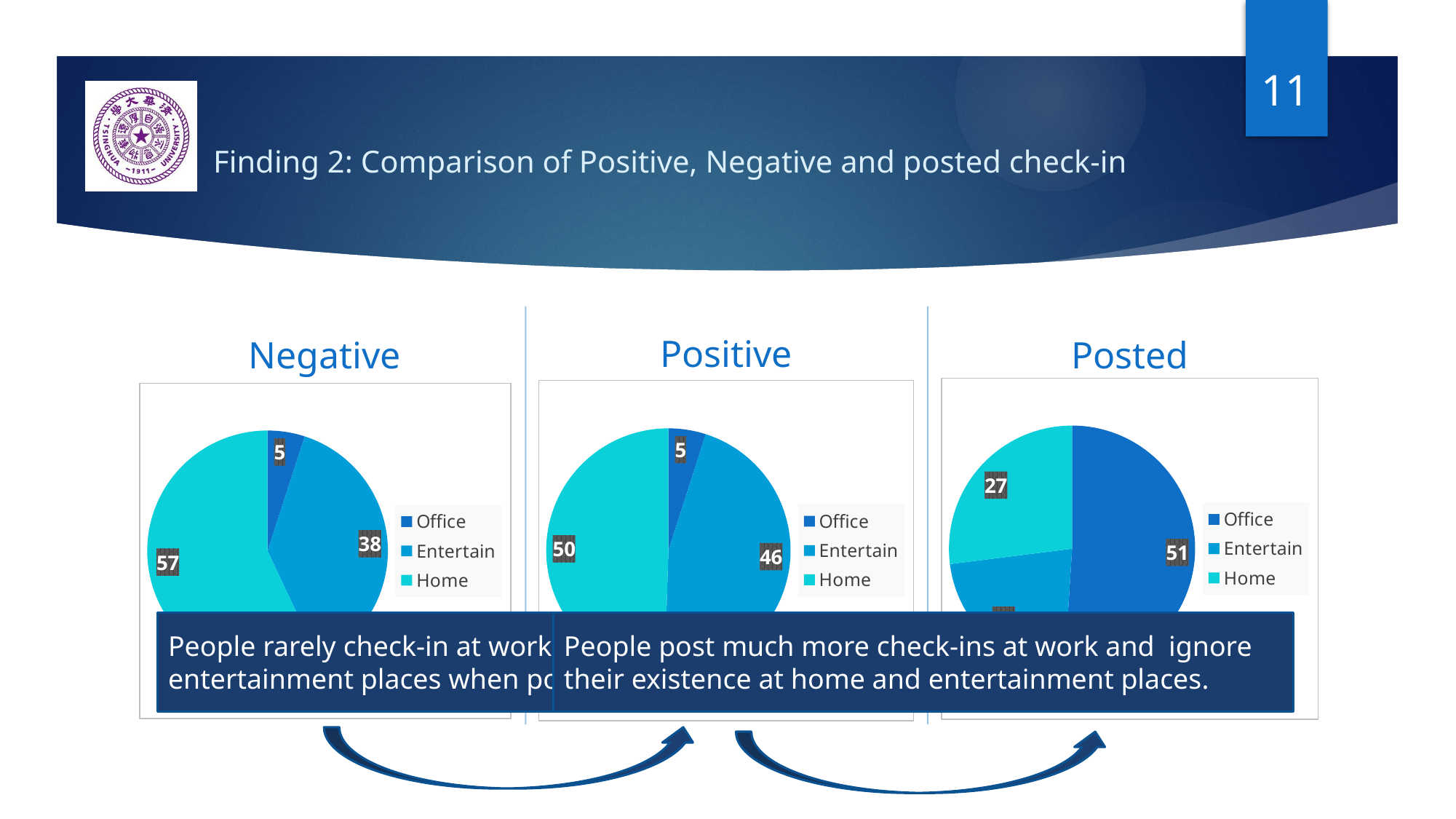
In the Positive pie chart, which category has the smallest slice? Office In the Posted pie chart, what is the difference between the Office and Home values? 24 In the Negative pie chart, what is the value for Entertain? 38 In the Posted pie chart, what is the value for Office? 51 How many categories does the legend of the Positive pie chart list? 3 In the Negative pie chart, what is the difference between the Home and Entertain values? 19 In the Negative pie chart, what is the value for Home? 57 In the Posted pie chart, what is the value for Home? 27 In the Positive pie chart, what is the value for Office? 5 In the Negative pie chart, which category has the largest slice? Home In the Posted pie chart, which category has the largest slice? Office In the Positive pie chart, what is the value for Entertain? 46